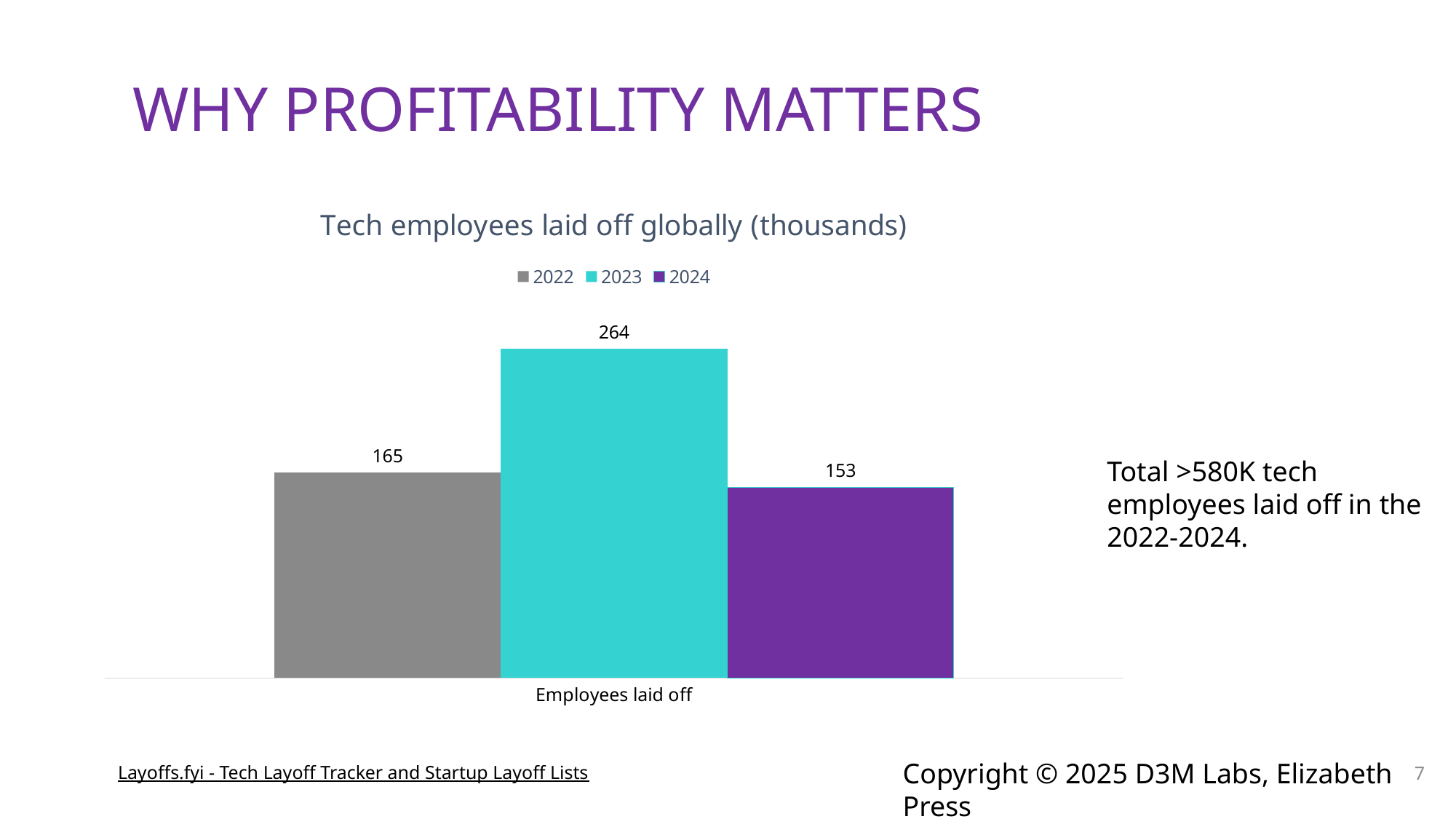
What is the value for 2023 in the chart? 264 What colour is the bar for 2024? Purple What is the difference between the 2023 and 2022 values? 99 What is the value for 2022 in the chart? 165 What is the value for 2024 in the chart? 153 Which year has the highest number of tech employees laid off? 2023 Which is larger, the value for 2022 or the value for 2024? 2022 What kind of chart is shown on the slide? Bar chart Which year has the lowest number of tech employees laid off? 2024 What is the difference between the 2022 and 2024 values? 12 What is the title of the chart? Tech employees laid off globally (thousands) How many series does the legend list? 3